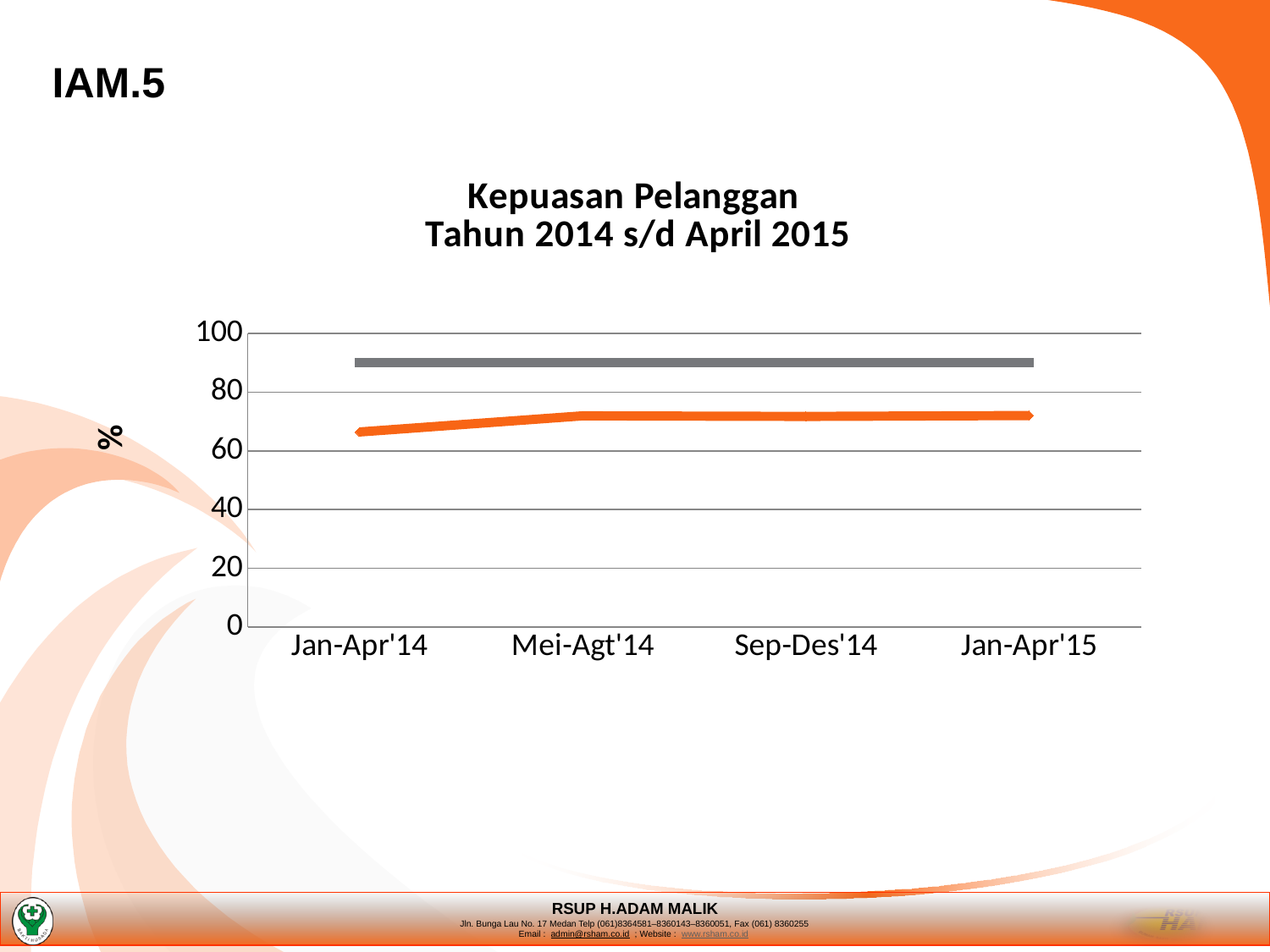
Which line is higher across all periods, the gray line or the orange line? the gray line Is the value of the gray line greater or less than 100? less Is the value of the orange line for Jan-Apr'14 greater or less than 60? greater How many periods are shown on the x axis of the chart? 4 What is the title of the chart? Kepuasan Pelanggan Tahun 2014 s/d April 2015 What kind of chart is shown on the slide? line chart Is the value of the orange line for Jan-Apr'14 greater or less than 80? less Which period has the lowest value on the orange line? Jan-Apr'14 What is the label on the vertical axis of the chart? % Does the orange line rise or fall from Jan-Apr'14 to Mei-Agt'14? rise